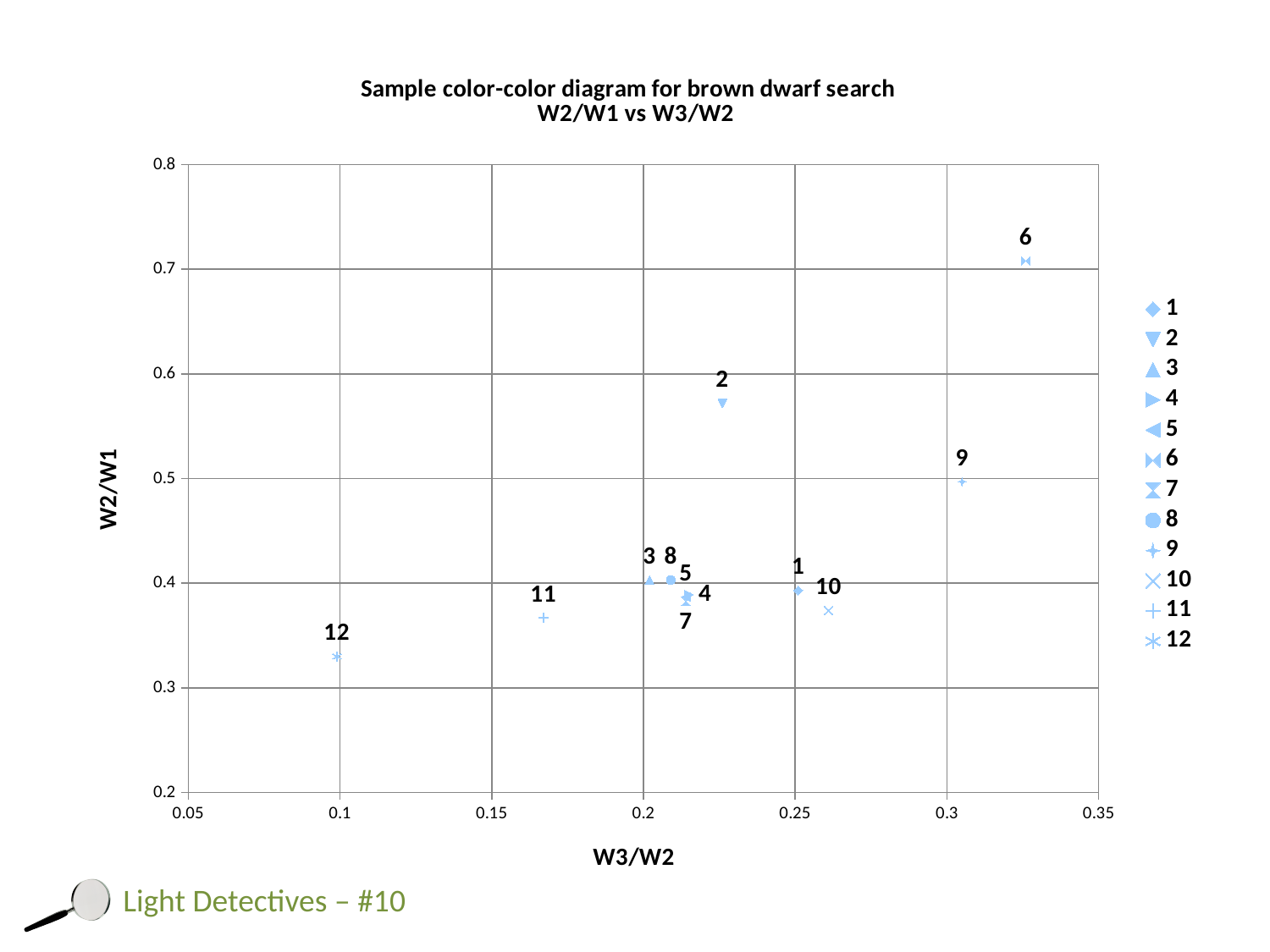
Which point has the lowest W3/W2 value? 12 How many series does the legend list? 12 What is the label of the x axis? W3/W2 Which point has the highest W3/W2 value? 6 Which point has the lowest W2/W1 value? 12 Which has the larger W2/W1 value, point 2 or point 9? point 2 What kind of chart is shown on the slide? scatter chart Which point has the highest W2/W1 value? 6 Is the W3/W2 value for point 11 greater or less than 0.2? less Is the W2/W1 value for point 2 greater or less than 0.5? greater Is the W3/W2 value for point 6 greater or less than 0.3? greater Which has the larger W2/W1 value, point 11 or point 12? point 11